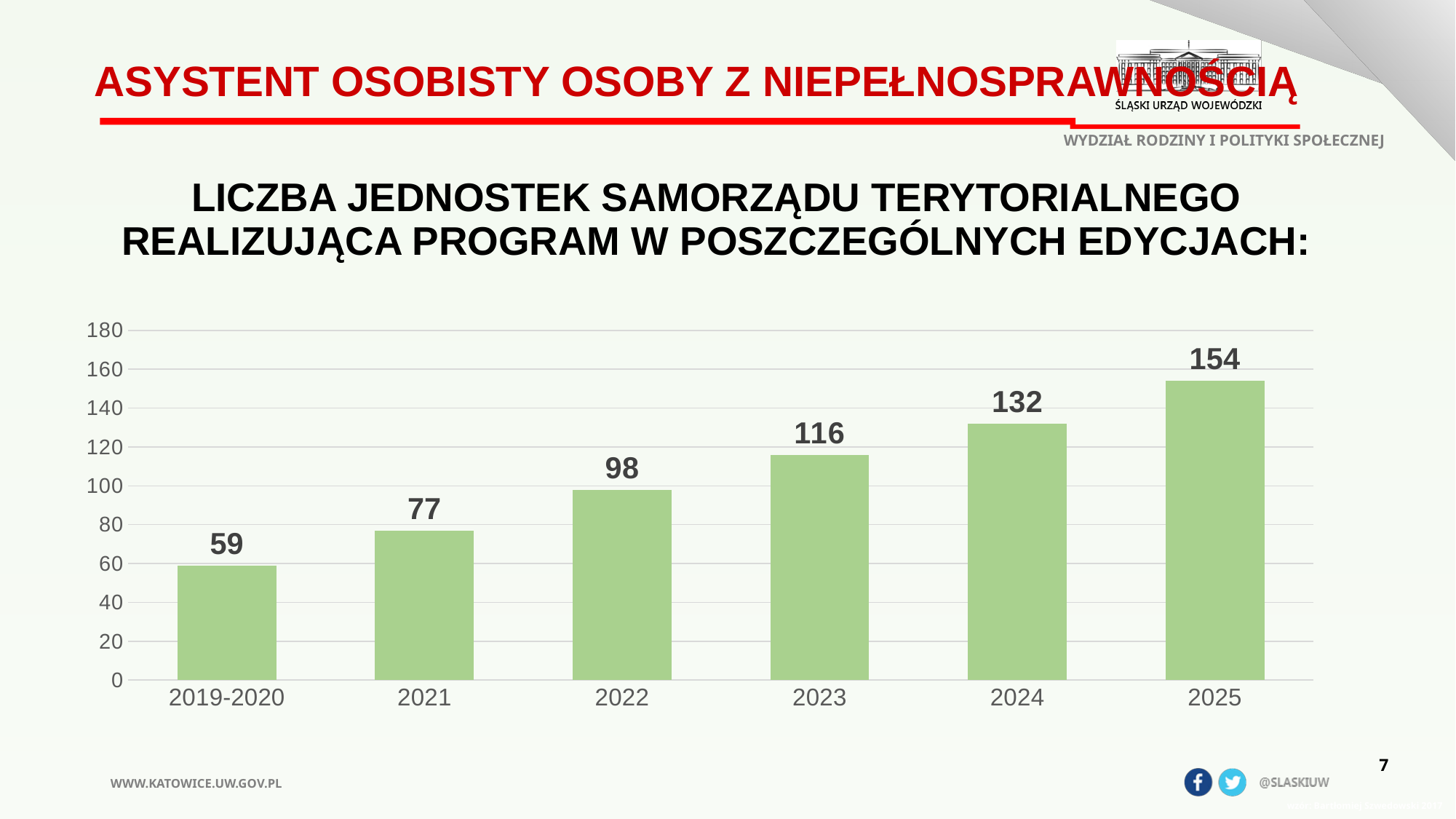
Which is larger, the value for 2022 or the value for 2023? 2023 What is the difference between the values for 2022 and 2021? 21 Which category has the lowest value? 2019-2020 What kind of chart is shown on the slide? bar chart Is the value for 2024 greater or less than 120? greater What is the value for 2023? 116 What is the difference between the values for 2025 and 2024? 22 What is the value for 2025? 154 How many categories are shown on the x axis? 6 Do the values rise or fall from 2019-2020 to 2025? rise Which category has the highest value? 2025 What is the value for 2019-2020? 59